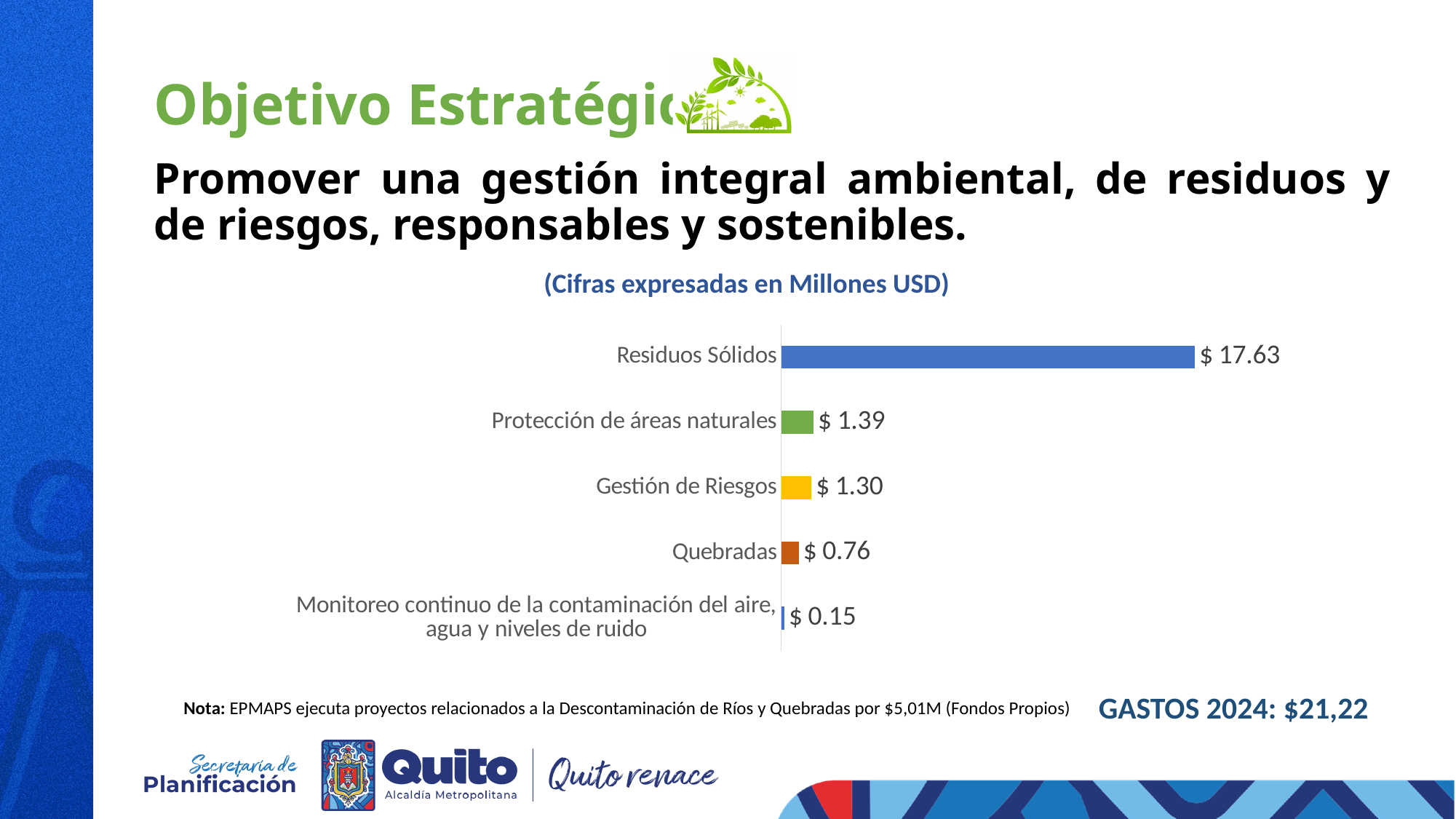
What is the difference between the values for Gestión de Riesgos and Quebradas? $ 0.54 What is the value for Gestión de Riesgos? $ 1.30 What is the value for Protección de áreas naturales? $ 1.39 Which category has the highest value? Residuos Sólidos How many categories are shown in the chart? 5 What kind of chart is shown on the slide? Bar chart What is the value for Residuos Sólidos? $ 17.63 Which category has the lowest value? Monitoreo continuo de la contaminación del aire, agua y niveles de ruido What is the value for Quebradas? $ 0.76 What is the value for Monitoreo continuo de la contaminación del aire, agua y niveles de ruido? $ 0.15 What is the difference between the values for Residuos Sólidos and Protección de áreas naturales? $ 16.24 Which is larger, the value for Protección de áreas naturales or the value for Quebradas? Protección de áreas naturales